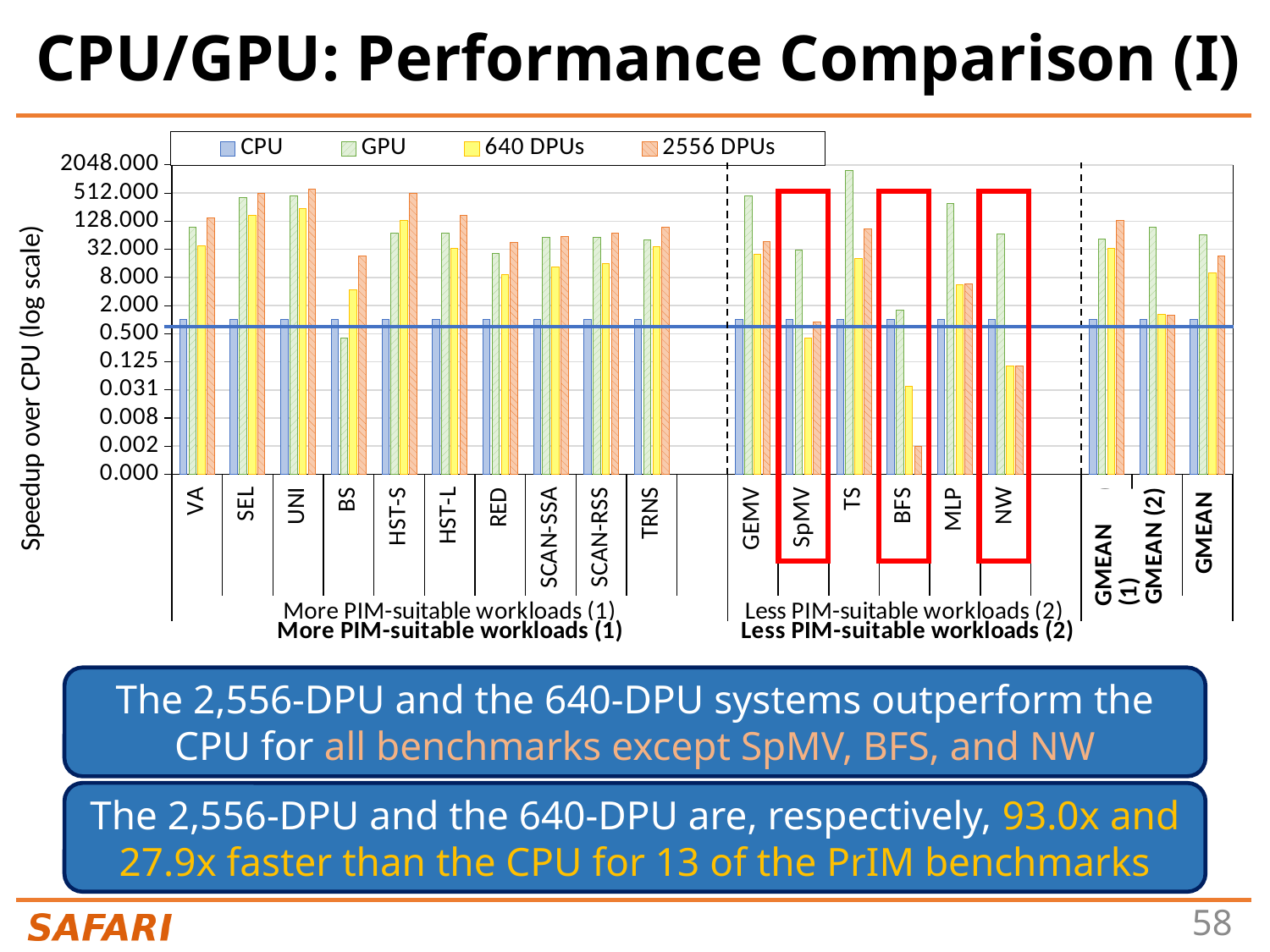
For GEMV, which is larger: the GPU value or the 2556 DPUs value? GPU Is the 2556 DPUs value for BFS greater or less than 0.008? less How many series does the legend list? 4 For VA, which is larger: the GPU value or the 640 DPUs value? GPU Which category has the highest GPU bar? TS Is the GPU value for BS greater or less than 0.500? less How many benchmark categories are plotted along the x axis, including the GMEAN categories? 19 Is the GPU value for TS greater or less than 512.000? greater Which series is shown in yellow in the legend? 640 DPUs Which category has the lowest 2556 DPUs bar? BFS What is the label of the y axis? Speedup over CPU (log scale) What kind of chart is shown on the slide? bar chart